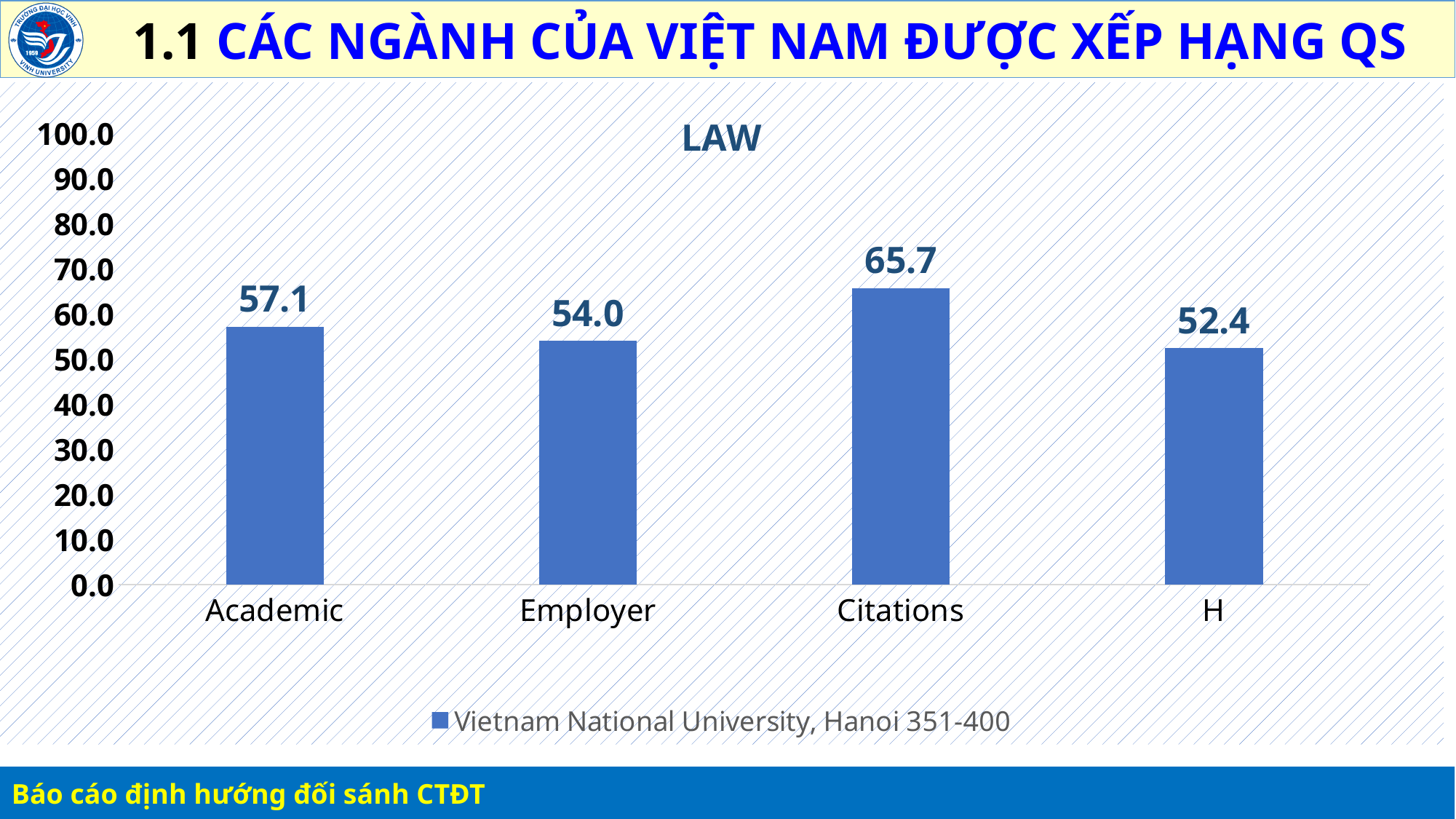
Which category has the highest value? Citations What is the value for Employer? 54.0 Which category has the lowest value? H What is the value for H? 52.4 Which is larger, the value for Academic or the value for Employer? Academic What is the value for Academic? 57.1 What is the value for Citations? 65.7 How many categories are shown on the x axis? 4 What is the difference between the values for Citations and Academic? 8.6 What kind of chart is shown? bar chart Is the value for Citations greater or less than 60.0? greater What is the title of the chart? LAW